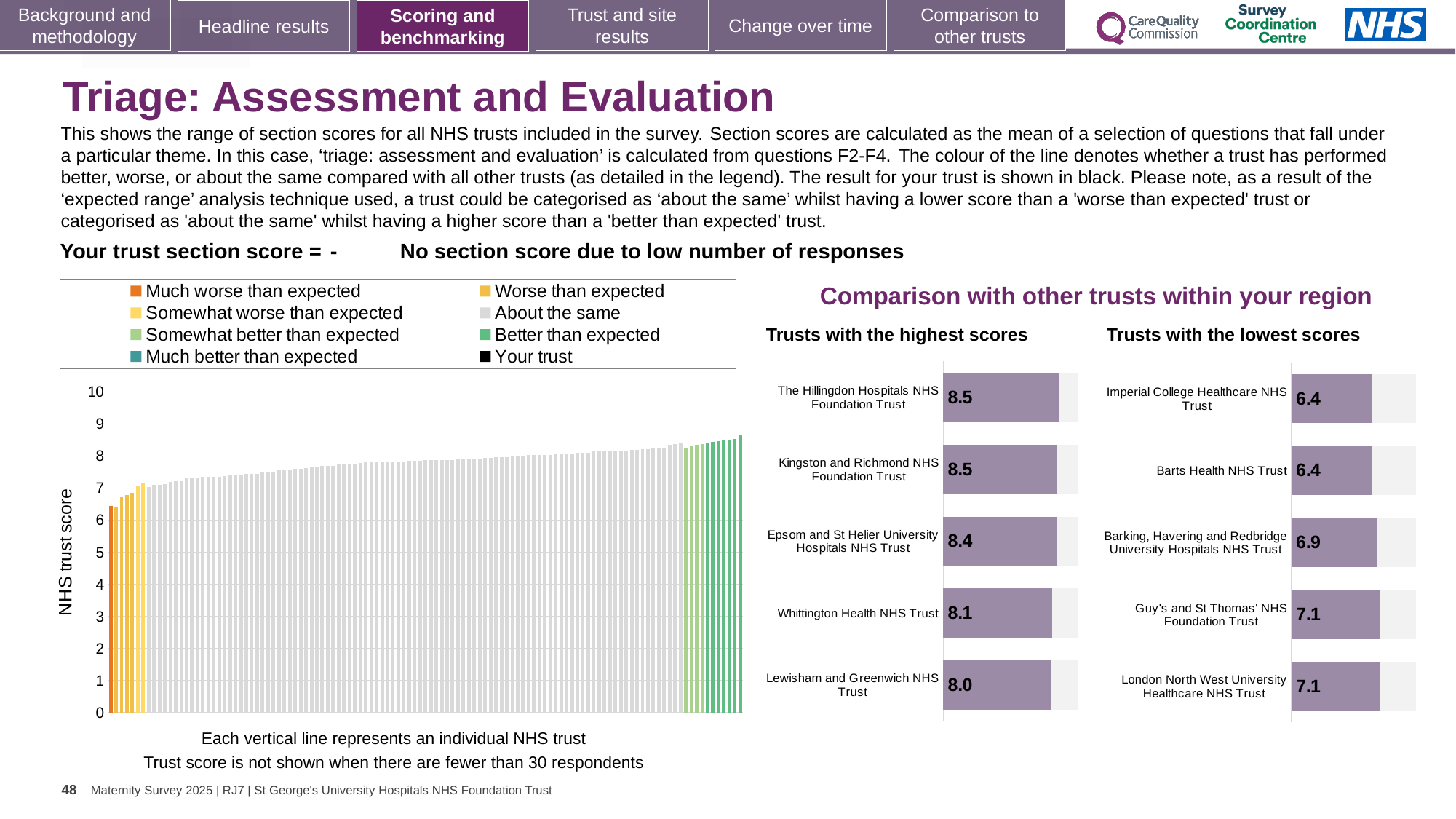
In the 'Trusts with the lowest scores' chart, which has the higher score: Guy's and St Thomas' NHS Foundation Trust or Barts Health NHS Trust? Guy's and St Thomas' NHS Foundation Trust In the 'Trusts with the highest scores' chart, what is the difference between the scores of The Hillingdon Hospitals NHS Foundation Trust and Lewisham and Greenwich NHS Trust? 0.5 In the 'Trusts with the lowest scores' chart, what is the difference between the scores of Barking, Havering and Redbridge University Hospitals NHS Trust and Imperial College Healthcare NHS Trust? 0.5 In the 'Trusts with the highest scores' chart, which trust has the lowest score? Lewisham and Greenwich NHS Trust In the 'Trusts with the highest scores' chart, what is the score for The Hillingdon Hospitals NHS Foundation Trust? 8.5 In the NHS trust score chart on the left, is the value of the leftmost bar greater or less than 7? less In the 'Trusts with the highest scores' chart, which has the higher score: Epsom and St Helier University Hospitals NHS Trust or Whittington Health NHS Trust? Epsom and St Helier University Hospitals NHS Trust How many trusts are listed in the 'Trusts with the lowest scores' chart? 5 What kind of chart is the NHS trust score chart on the left of the slide? Bar chart In the NHS trust score chart on the left, do the values rise or fall from left to right? Rise In the 'Trusts with the lowest scores' chart, what is the score for Barking, Havering and Redbridge University Hospitals NHS Trust? 6.9 How many entries does the legend of the NHS trust score chart on the left list? 8